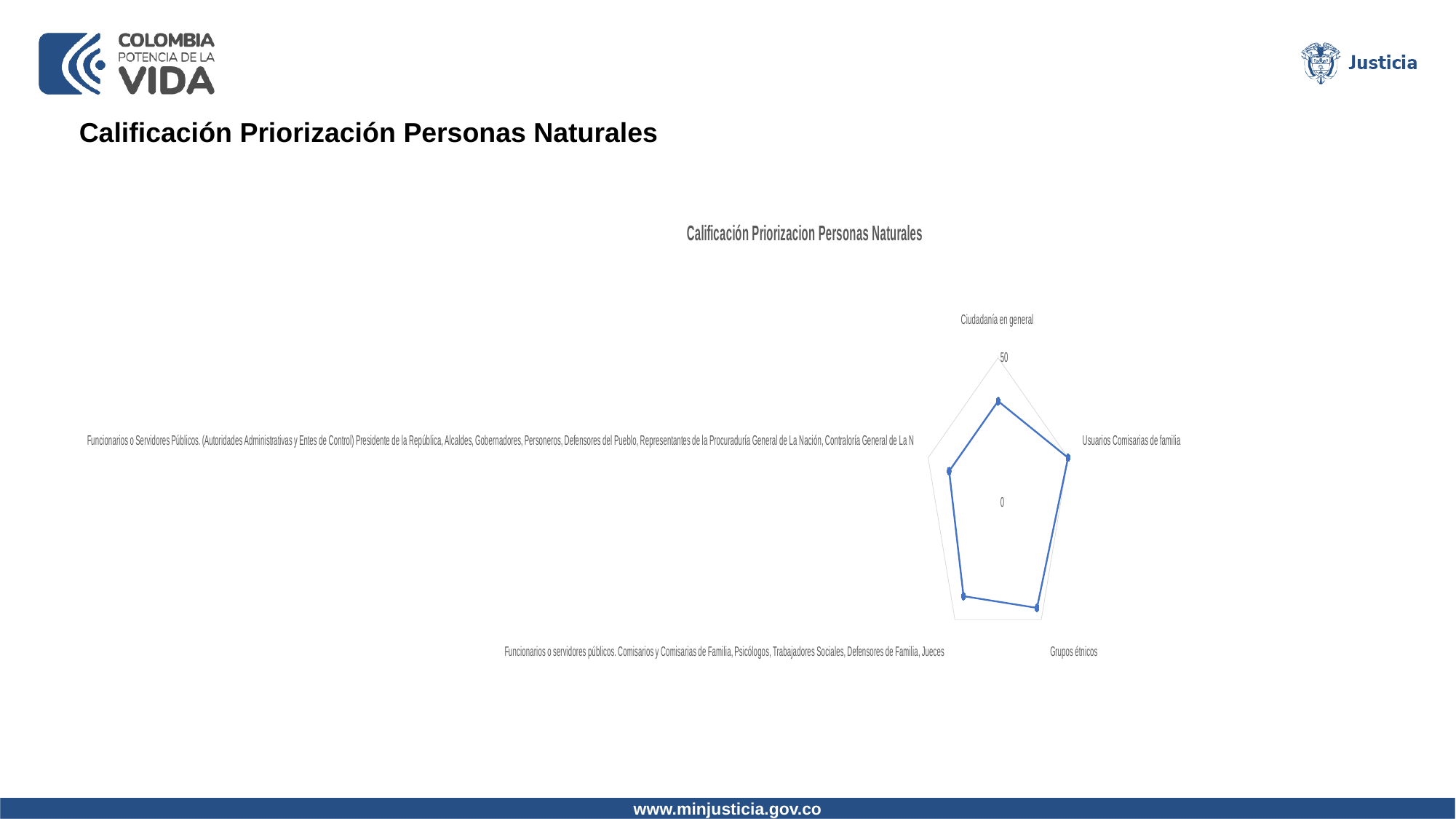
How many categories are plotted on the radar chart? 5 Which has the larger value, Grupos étnicos or Ciudadanía en general? Grupos étnicos Is the value for Grupos étnicos greater or less than 0? greater Which has the larger value, Grupos étnicos or Funcionarios o Servidores Públicos (Autoridades Administrativas y Entes de Control)? Grupos étnicos What is the title of the chart? Calificación Priorizacion Personas Naturales What kind of chart is shown on the slide? radar chart Is the value for Ciudadanía en general greater or less than 50? less What is the maximum value shown on the chart's axis scale? 50 Which has the larger value, Usuarios Comisarias de familia or Ciudadanía en general? Usuarios Comisarias de familia